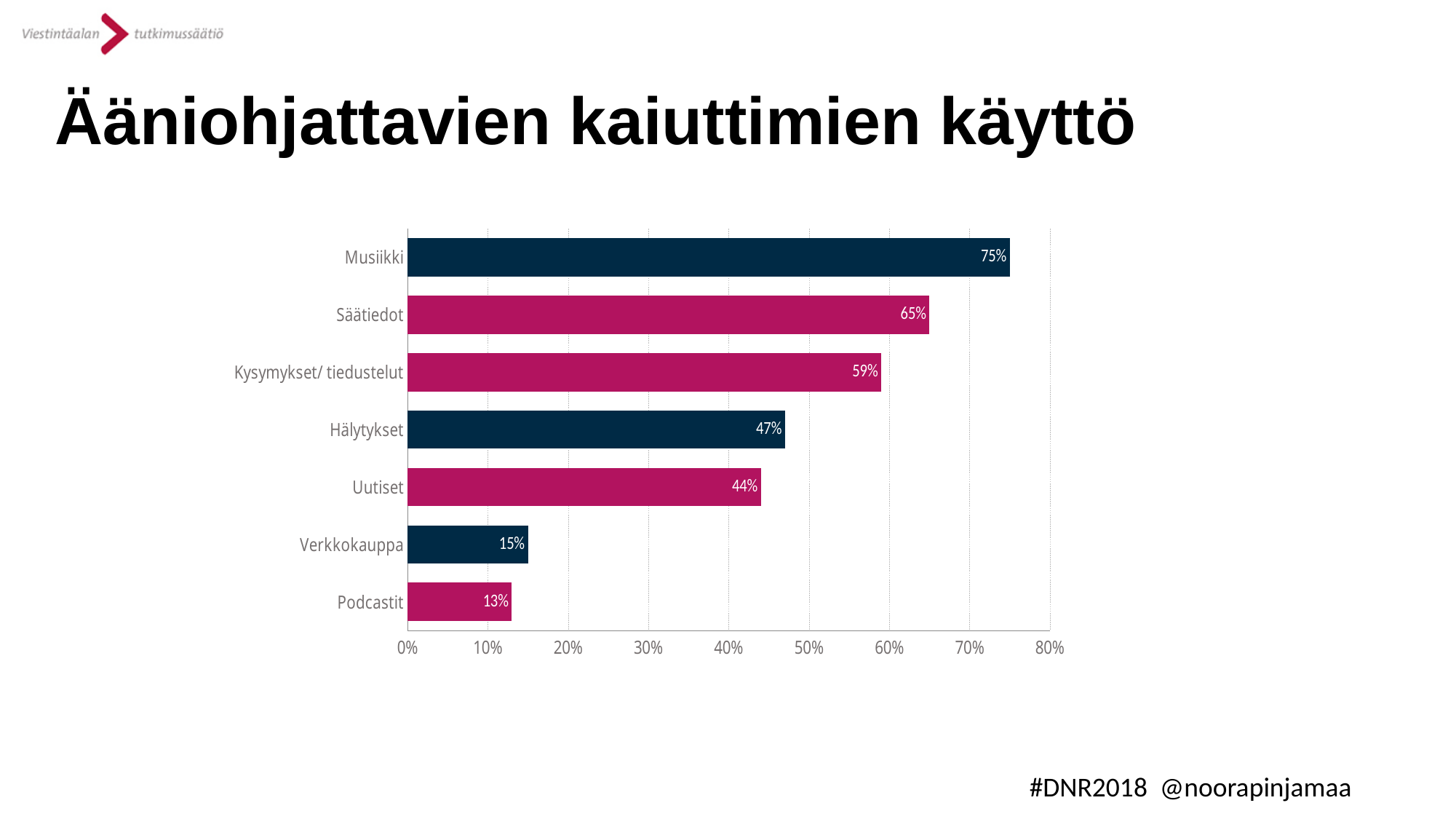
How many categories are shown in the chart? 7 What kind of chart is shown on the slide? Bar chart What is the value for Kysymykset/ tiedustelut? 59% Which is larger, the value for Uutiset or the value for Verkkokauppa? Uutiset Which category has the lowest value? Podcastit What is the value for Säätiedot? 65% What is the value for Musiikki? 75% Which category has the highest value? Musiikki What is the difference between the values for Hälytykset and Uutiset? 3% What is the difference between the values for Musiikki and Säätiedot? 10% What is the title of the slide? Ääniohjattavien kaiuttimien käyttö What is the value for Verkkokauppa? 15%